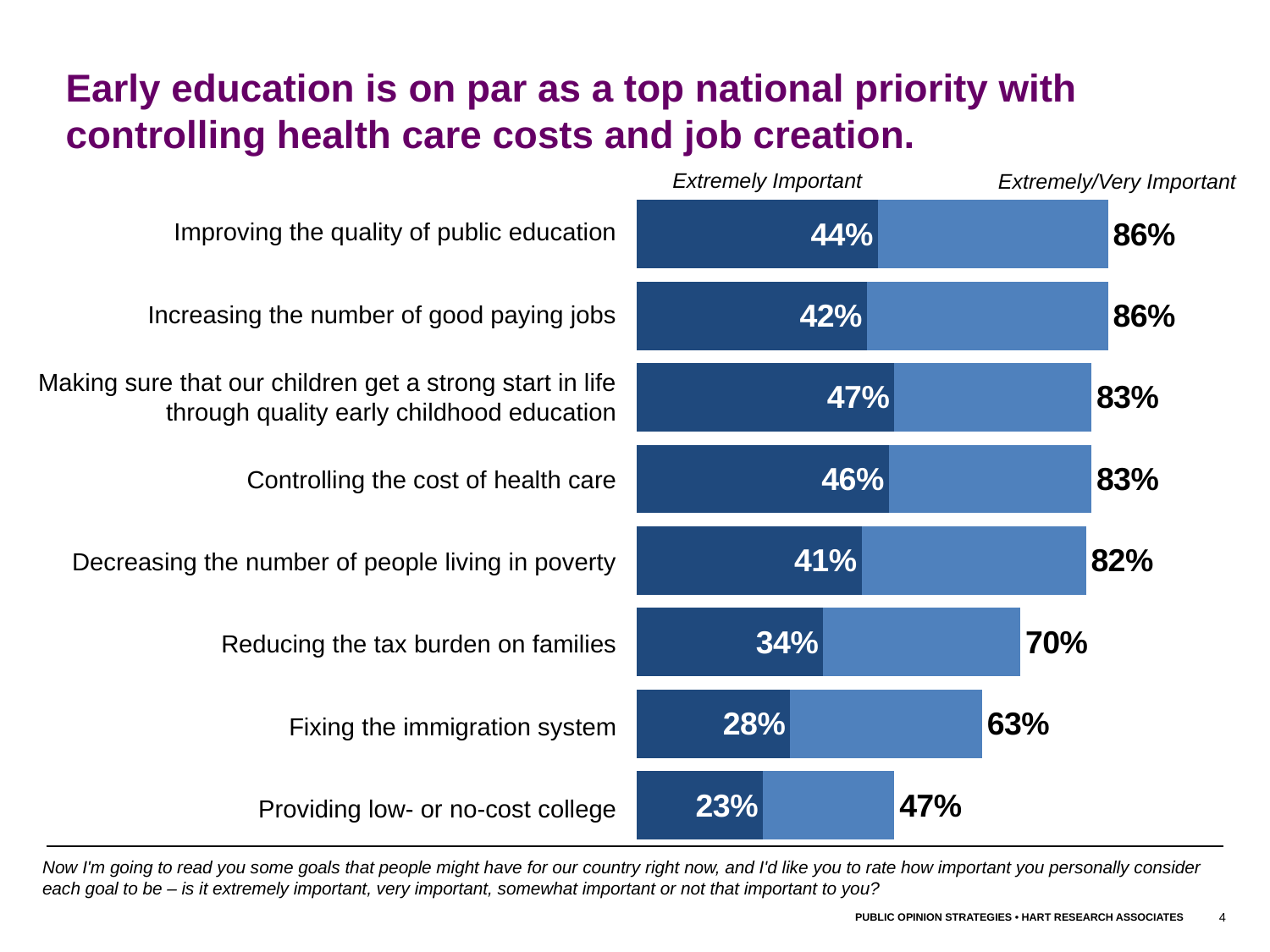
Which goal has the lowest Extremely/Very Important percentage? Providing low- or no-cost college Which has a higher Extremely Important percentage: 'Improving the quality of public education' or 'Reducing the tax burden on families'? Improving the quality of public education What is the difference between the Extremely/Very Important percentages for 'Reducing the tax burden on families' and 'Fixing the immigration system'? 7% How many goals are listed in the chart? 8 What kind of chart is shown on the slide? Bar chart What are the two series labels shown above the chart? Extremely Important; Extremely/Very Important What percentage rate 'Making sure that our children get a strong start in life through quality early childhood education' as extremely important? 47% What is the Extremely Important percentage for 'Providing low- or no-cost college'? 23% What is the Extremely/Very Important percentage for 'Controlling the cost of health care'? 83% What is the Extremely/Very Important percentage for 'Increasing the number of good paying jobs'? 86% How many series does the chart show? 2 Which goal has the highest Extremely Important percentage? Making sure that our children get a strong start in life through quality early childhood education